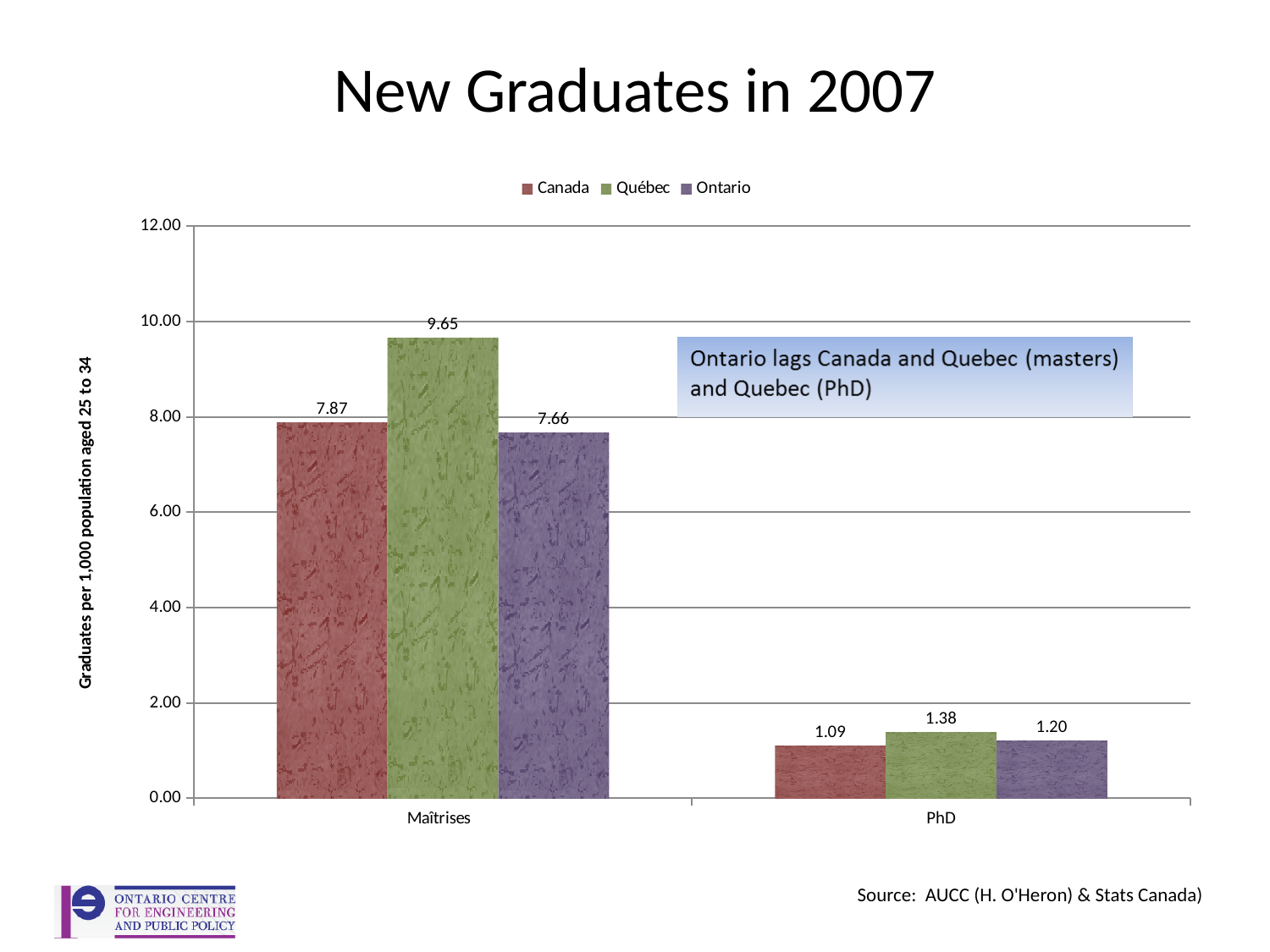
What is the difference between the Québec and Ontario values in the Maîtrises category? 1.99 What is the value for Ontario in the Maîtrises category? 7.66 Which series has the highest value in the Maîtrises category? Québec How many series does the legend list? 3 What is the value for Québec in the Maîtrises category? 9.65 What kind of chart is shown on the slide? bar chart What is the difference between the Québec and Canada values in the PhD category? 0.29 Which series has the lowest value in the PhD category? Canada What is the value for Canada in the PhD category? 1.09 Which is larger in the PhD category, Ontario or Canada? Ontario Is the value for Canada in the Maîtrises category greater or less than 8.00? less How many categories are shown on the x axis? 2